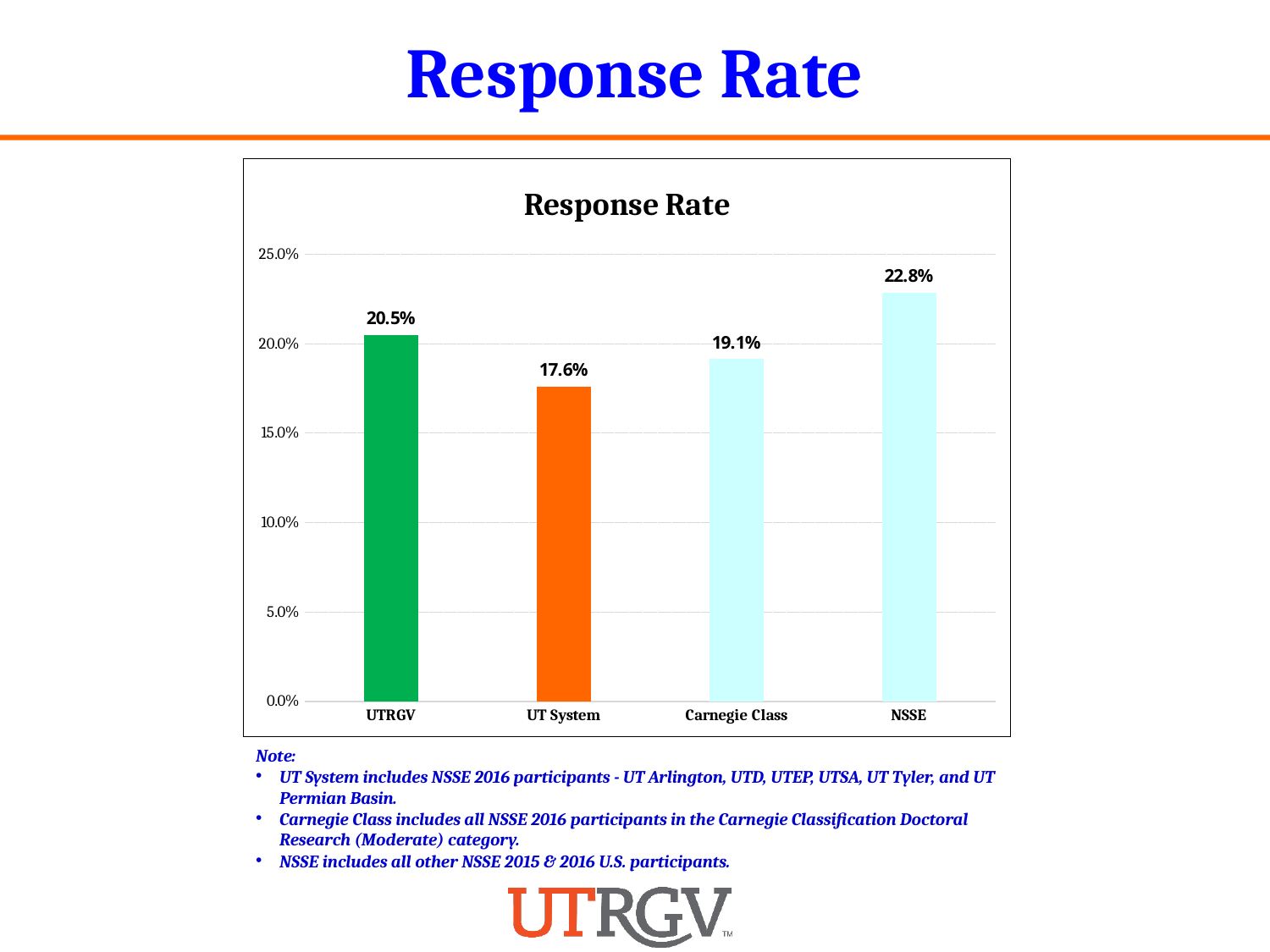
What is the response rate for NSSE? 22.8% How many categories are shown in the chart? 4 Which category has the lowest response rate? UT System What is the difference between the NSSE and UTRGV response rates? 2.3% Which category has the highest response rate? NSSE What kind of chart is shown on the slide? Bar chart What is the response rate for UTRGV? 20.5% What is the difference between the UTRGV and UT System response rates? 2.9% What is the response rate for UT System? 17.6% What is the response rate for Carnegie Class? 19.1% Which has a higher response rate, UTRGV or Carnegie Class? UTRGV Is the value for UT System greater or less than 20.0%? less